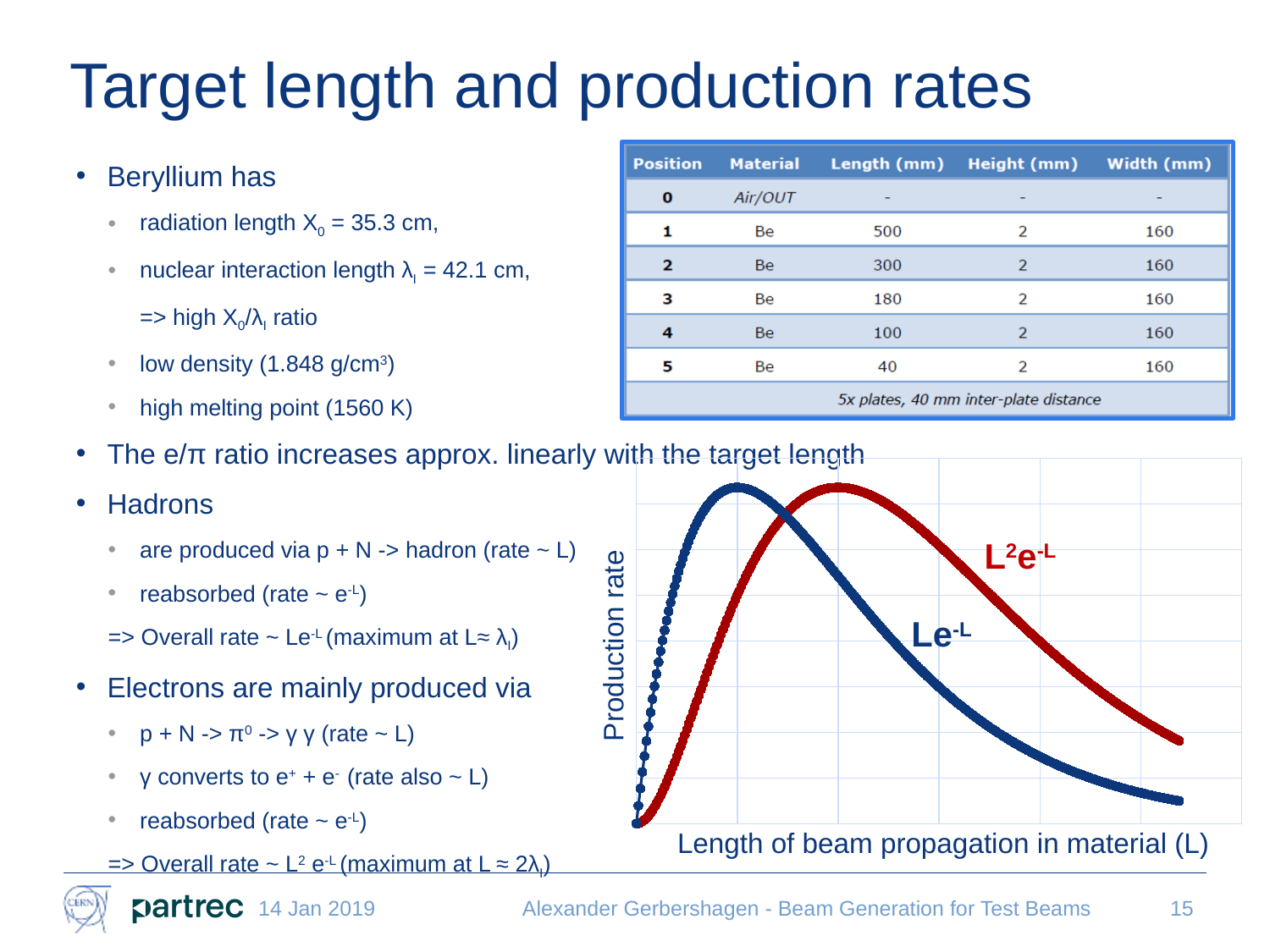
How many curves are plotted in the chart at the bottom right of the slide? 2 In the chart at the bottom right, which curve reaches its maximum at a smaller value of L, Le^-L or L²e^-L? Le^-L What kind of chart is shown at the bottom right of the slide? line chart What is the label of the x axis of the chart at the bottom right of the slide? Length of beam propagation in material (L) In the chart at the bottom right, which curve is drawn in blue? Le^-L In the chart at the bottom right, how does the L²e^-L curve behave as L increases? rises to a peak, then falls In the chart at the bottom right, how does the Le^-L curve behave as L increases? rises to a peak, then falls What is the label of the y axis of the chart at the bottom right of the slide? Production rate In the chart at the bottom right, which curve has the higher production rate at the right end of the x axis, Le^-L or L²e^-L? L²e^-L